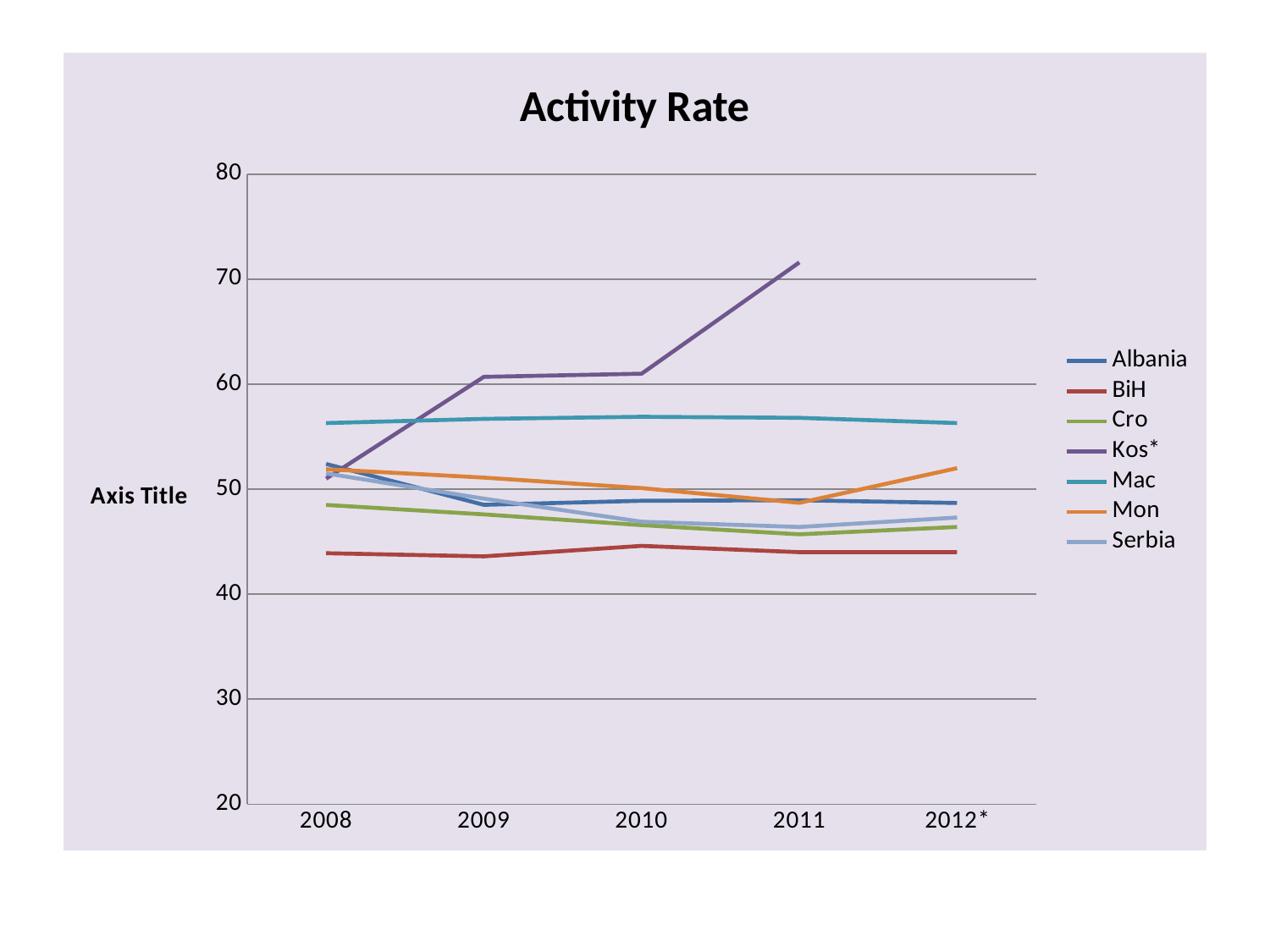
What is the title of the chart? Activity Rate Which series has the lowest value in 2012*? BiH How many years are shown on the x axis? 5 Which series has the highest value in 2011? Kos* How many series does the legend list? 7 Is the value for BiH in 2010 greater or less than 50? less In 2012*, which is larger: the value for Mon or the value for Cro? Mon Is the value for Mac in 2008 greater or less than 50? greater In 2010, which is larger: the value for Mac or the value for BiH? Mac What kind of chart is shown on the slide? line chart Is the value for Kos* in 2011 greater or less than 70? greater Does the Kos* line rise or fall from 2008 to 2011? rise